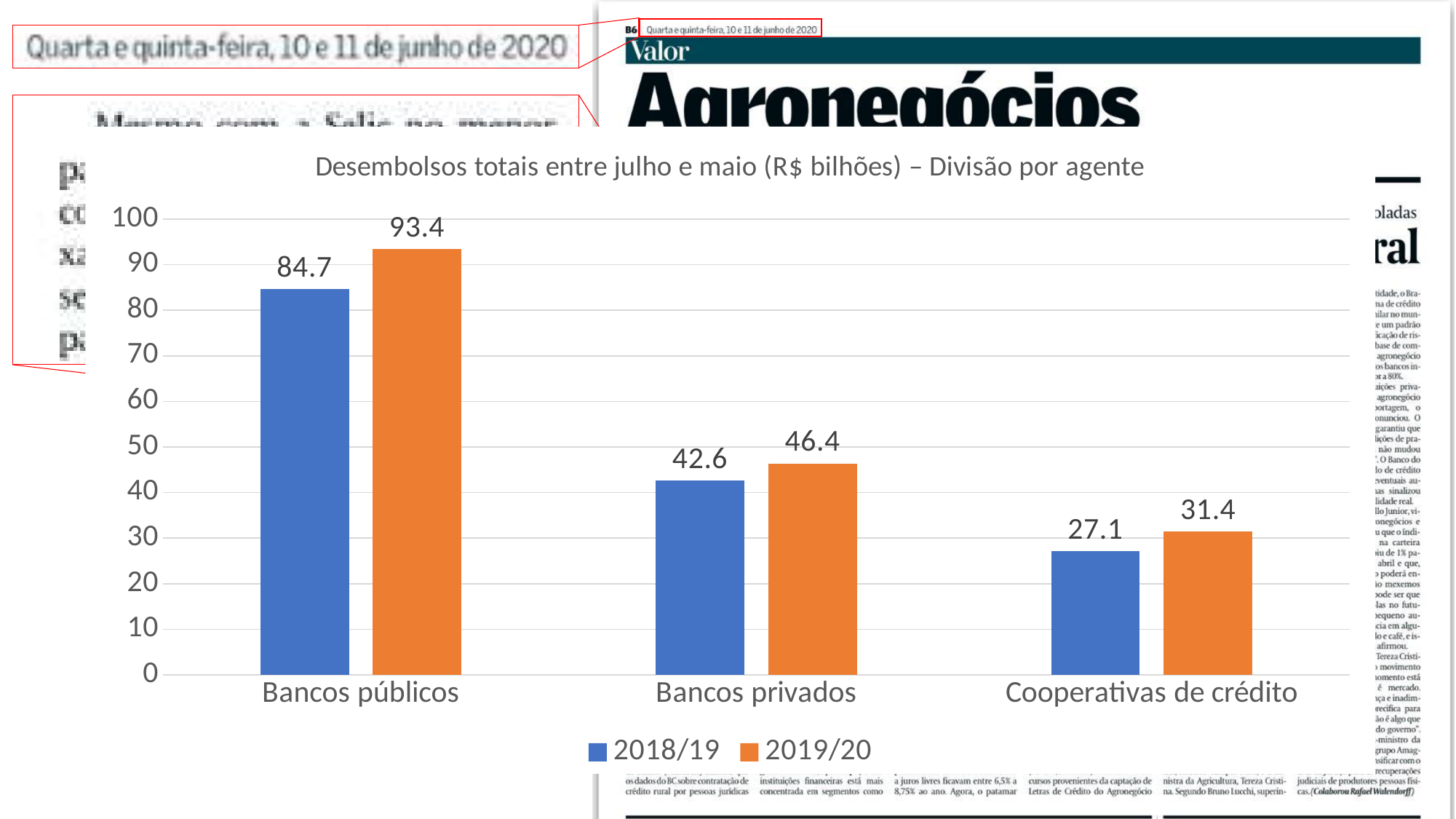
What is the value for Bancos privados in the 2019/20 series? 46.4 What is the difference between the 2019/20 and 2018/19 values for Cooperativas de crédito? 4.3 What is the value for Bancos públicos in the 2018/19 series? 84.7 Which category has the highest value in the 2019/20 series? Bancos públicos What is the title of the chart? Desembolsos totais entre julho e maio (R$ bilhões) – Divisão por agente How many categories are shown on the x axis? 3 What is the difference between the 2019/20 and 2018/19 values for Bancos públicos? 8.7 Which is larger: the 2018/19 value for Bancos privados or the 2019/20 value for Cooperativas de crédito? 2018/19 value for Bancos privados What is the value for Cooperativas de crédito in the 2018/19 series? 27.1 What kind of chart is shown on the slide? Bar chart Which category has the lowest value in the 2018/19 series? Cooperativas de crédito How many series does the legend list? 2